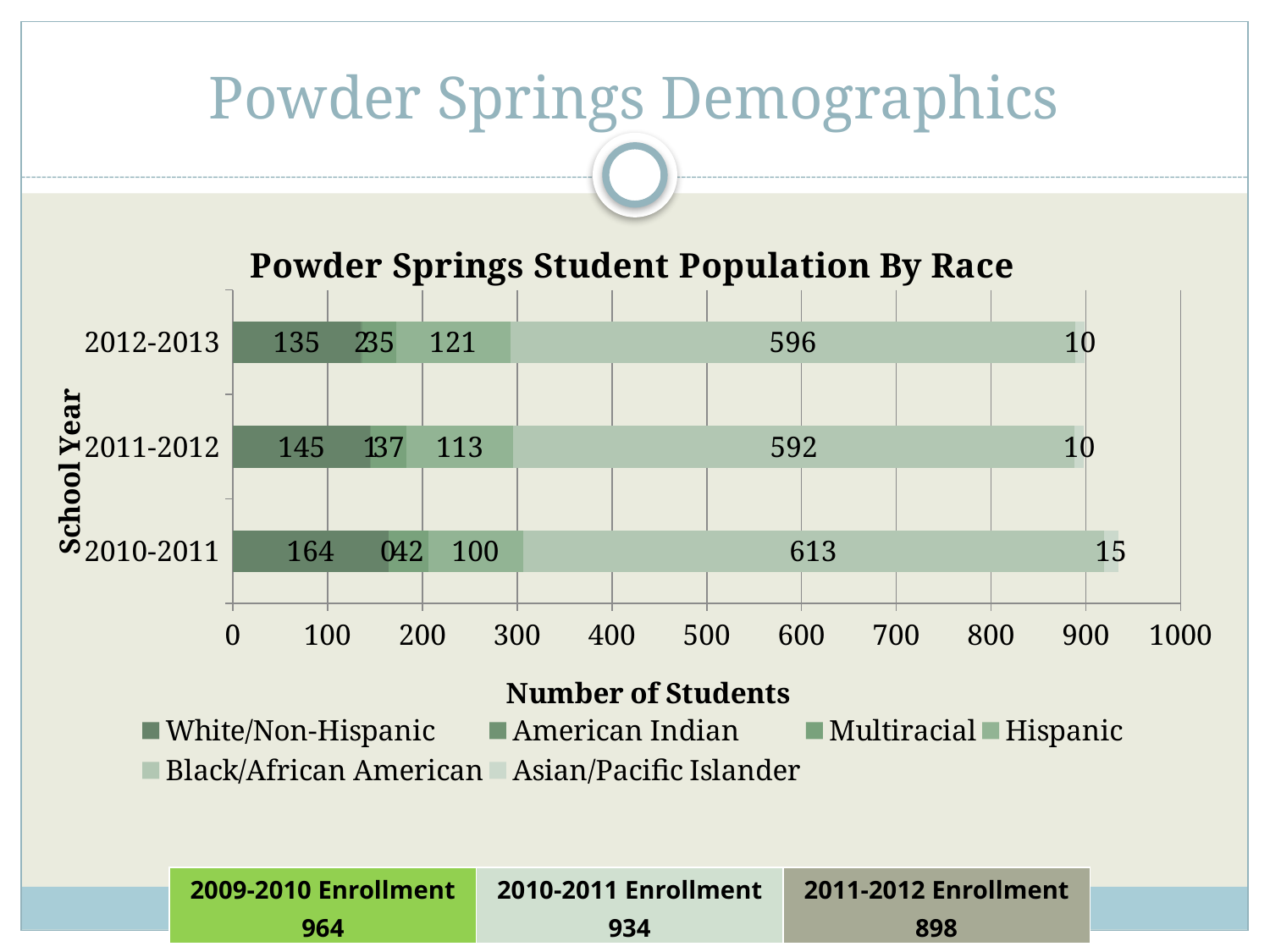
How many series does the legend list? 6 What is the number of White/Non-Hispanic students in 2012-2013? 135 Which school year has the highest number of Black/African American students? 2010-2011 What is the number of Hispanic students in 2011-2012? 113 Which school year has the lowest number of White/Non-Hispanic students? 2012-2013 How many school years are shown in the chart? 3 What is the difference in Black/African American students between 2010-2011 and 2011-2012? 21 What kind of chart is shown on the slide? Stacked bar chart Which school year has more Hispanic students, 2012-2013 or 2010-2011? 2012-2013 How many more White/Non-Hispanic students were there in 2010-2011 than in 2012-2013? 29 What is the number of Black/African American students in 2010-2011? 613 What is the number of Asian/Pacific Islander students in 2010-2011? 15